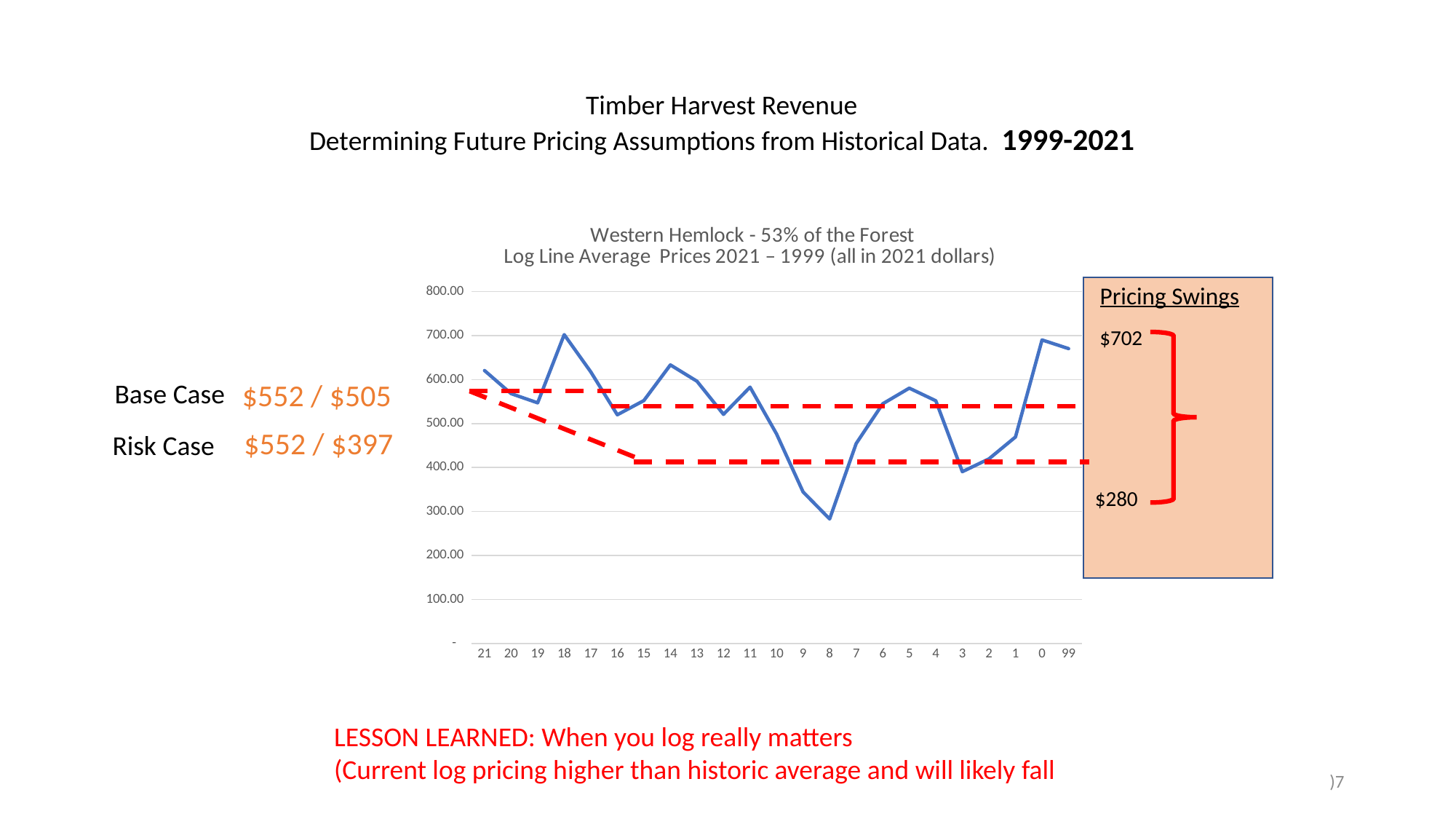
Is the value at x-axis label 18 greater or less than 600? greater Is the value at x-axis label 10 greater or less than 500? less Is the value at x-axis label 0 greater or less than 600? greater At which x-axis label does the line reach its lowest value? 8 At which x-axis label does the line reach its highest value? 18 Which has the larger value, x-axis label 0 or x-axis label 3? 0 What percentage of the forest does the chart title say Western Hemlock makes up? 53% What kind of chart is shown on the slide? line chart What is the highest tick value shown on the y axis of the chart? 800.00 Which has the larger value, x-axis label 18 or x-axis label 8? 18 How many points are plotted along the x axis of the chart? 23